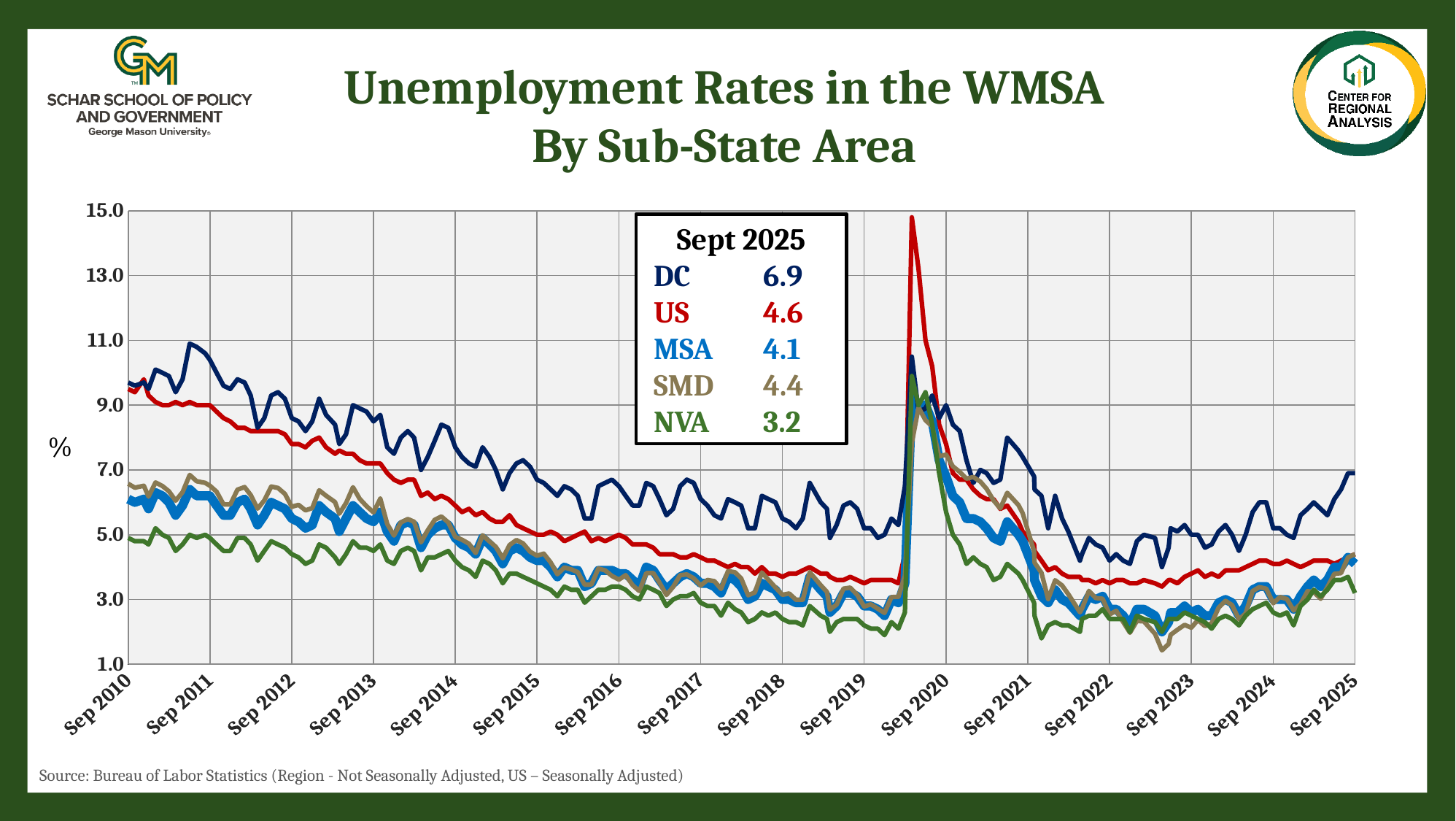
What is the difference between the US and MSA unemployment rates in Sept 2025? 0.5 What kind of chart is shown on the slide? Line chart In Sept 2025, which is higher: the US rate or the SMD rate? US Is the peak of the US unemployment rate around Sep 2020 greater or less than 13.0? greater What is the unemployment rate for the MSA in Sept 2025? 4.1 What is the difference between the DC and NVA unemployment rates in Sept 2025? 3.7 Which area has the lowest unemployment rate in Sept 2025? NVA Does the DC unemployment rate generally rise or fall from Sep 2010 to Sep 2019? fall Which area has the highest unemployment rate in Sept 2025? DC What is the unemployment rate for DC in Sept 2025? 6.9 What is the unemployment rate for NVA in Sept 2025? 3.2 How many series are plotted on the chart? 5